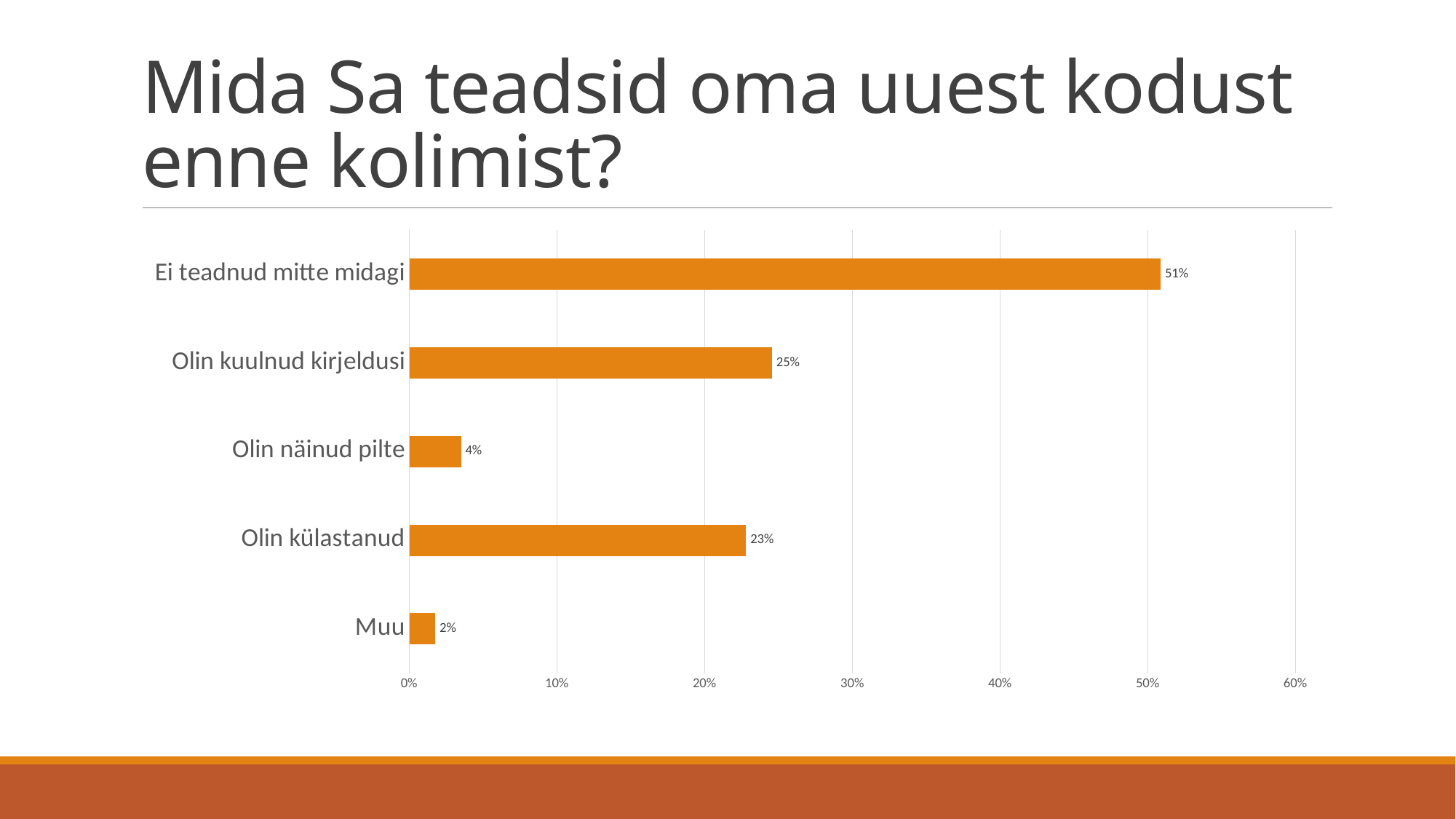
Which is larger, the value for "Olin kuulnud kirjeldusi" or the value for "Olin külastanud"? Olin kuulnud kirjeldusi What is the value for "Olin külastanud"? 23% What is the value for "Olin näinud pilte"? 4% Which category has the lowest value? Muu Which category has the highest value? Ei teadnud mitte midagi What is the value for "Muu"? 2% What kind of chart is shown on the slide? bar chart What is the value for "Ei teadnud mitte midagi"? 51% How many categories are shown in the chart? 5 What is the value for "Olin kuulnud kirjeldusi"? 25% Is the value for "Ei teadnud mitte midagi" greater or less than 40%? greater What is the difference between the values for "Ei teadnud mitte midagi" and "Olin kuulnud kirjeldusi"? 26%